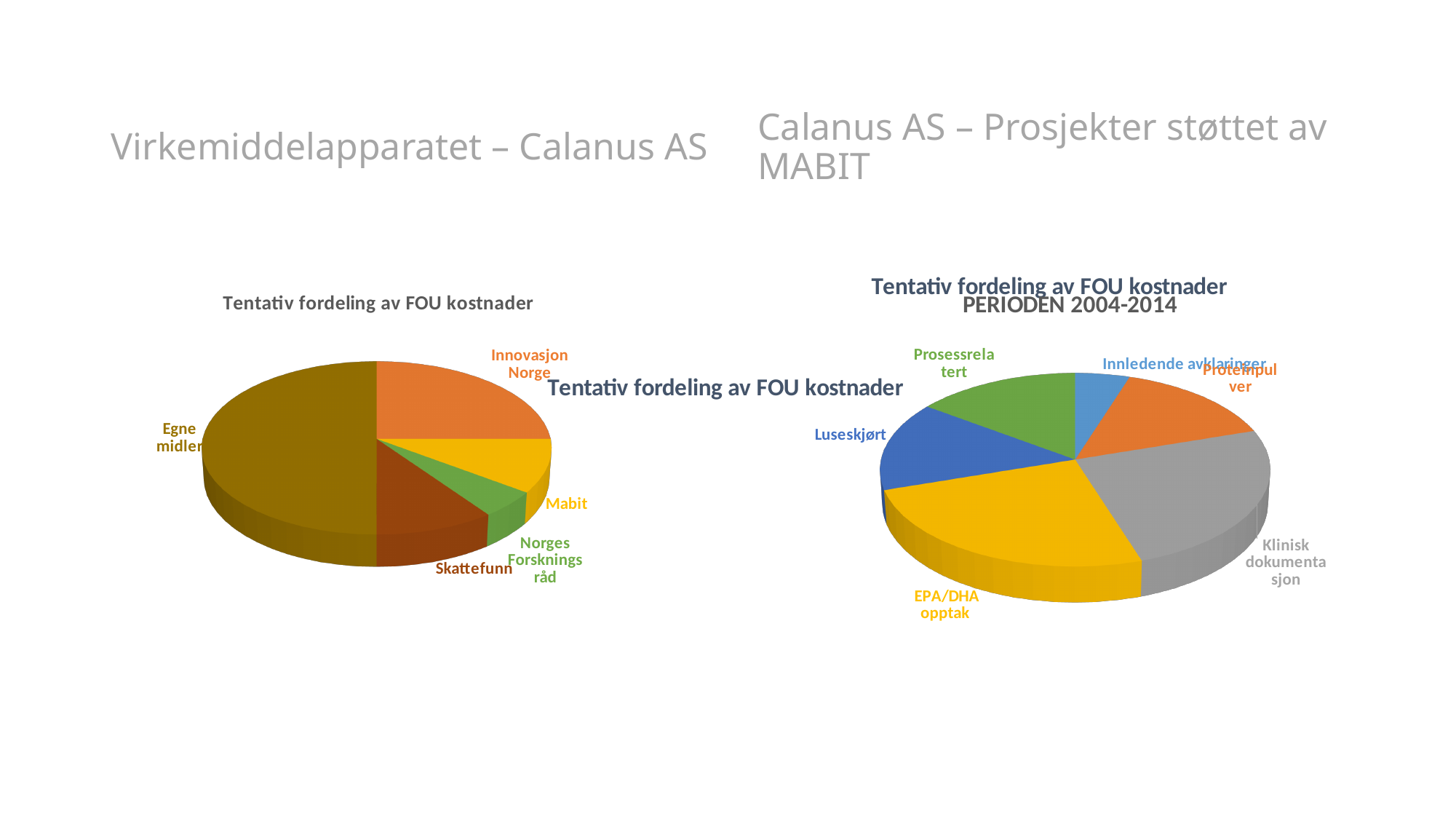
What kind of chart is the right chart titled "Tentativ fordeling av FOU kostnader PERIODEN 2004-2014"? Pie chart What kind of chart is the left chart titled "Tentativ fordeling av FOU kostnader"? Pie chart In the left pie chart, which category has the smallest share? Norges Forskningsråd In the left pie chart, which is larger: Egne midler or Innovasjon Norge? Egne midler In the right pie chart (PERIODEN 2004-2014), how many slices (categories) are shown? 6 In the left pie chart, how many slices (categories) are shown? 5 In the right pie chart (PERIODEN 2004-2014), which category has the smallest share? Innledende avklaringer In the left pie chart, which is larger: Innovasjon Norge or Skattefunn? Innovasjon Norge In the left pie chart, which category has the largest share? Egne midler What period is named in the title of the right pie chart? 2004-2014 In the right pie chart (PERIODEN 2004-2014), which is larger: Klinisk dokumentasjon or Proteinpulver? Klinisk dokumentasjon